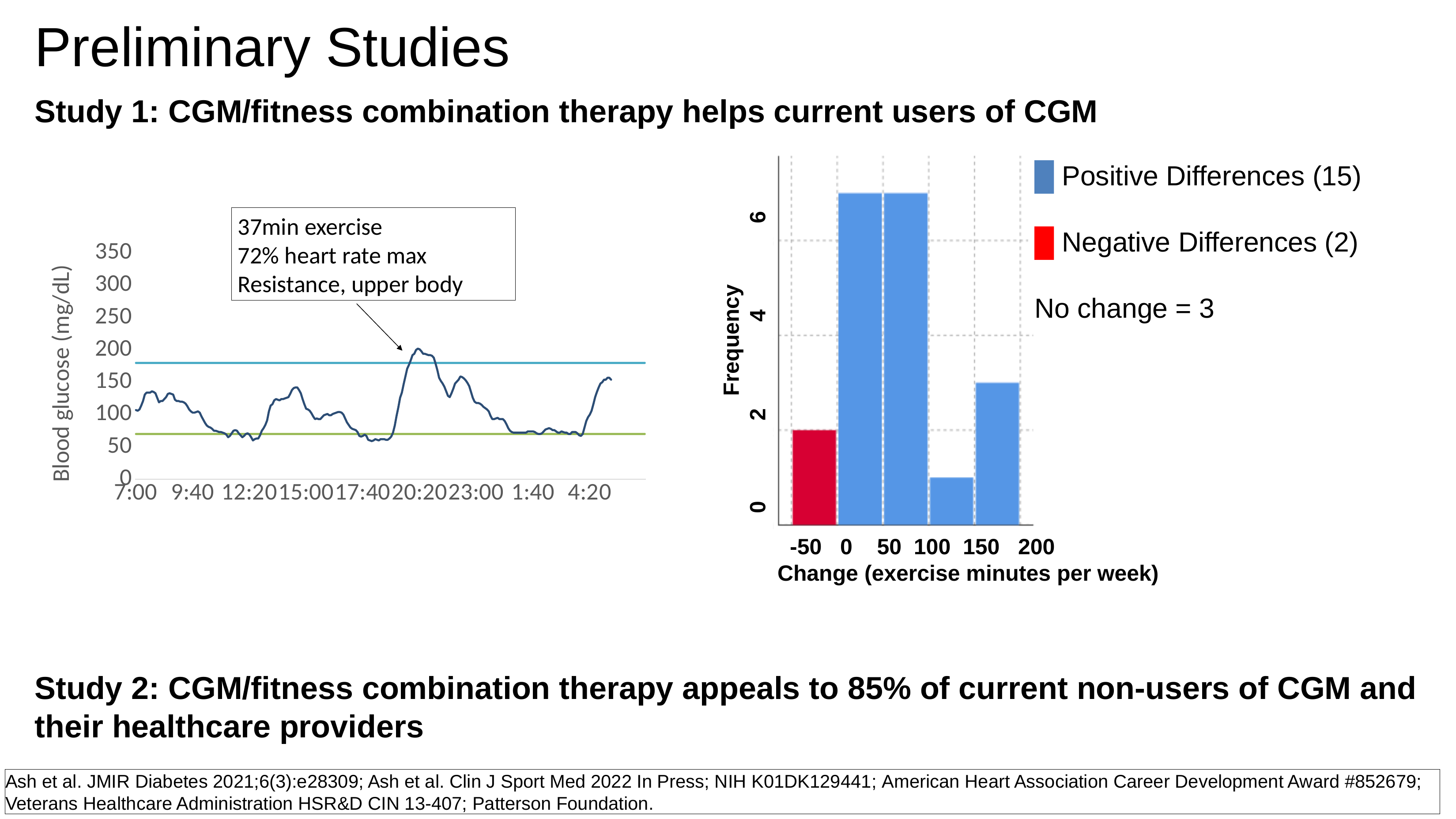
In the chart on the right, is the frequency for the 0 to 50 bin greater or less than 6? greater In the chart on the right, is the frequency for the 150 to 200 bin greater or less than 4? less In the chart on the right, how many bars are plotted? 5 In the chart on the right, how many series does the legend list? 2 In the chart on the right, how many negative differences does the legend report? 2 In the chart on the right, how many positive differences does the legend report? 15 What kind of chart is the chart on the right of the slide (Change in exercise minutes per week)? bar chart In the chart on the right, how many participants had no change, according to the text beside the legend? 3 In the chart on the right, which bar is taller: the -50 to 0 bin or the 150 to 200 bin? 150 to 200 In the chart on the right, which bin has the lowest frequency? 100 to 150 What kind of chart is the chart on the left of the slide (Blood glucose)? line chart In the chart on the left, is the peak blood glucose value near 20:20 greater or less than 150? greater